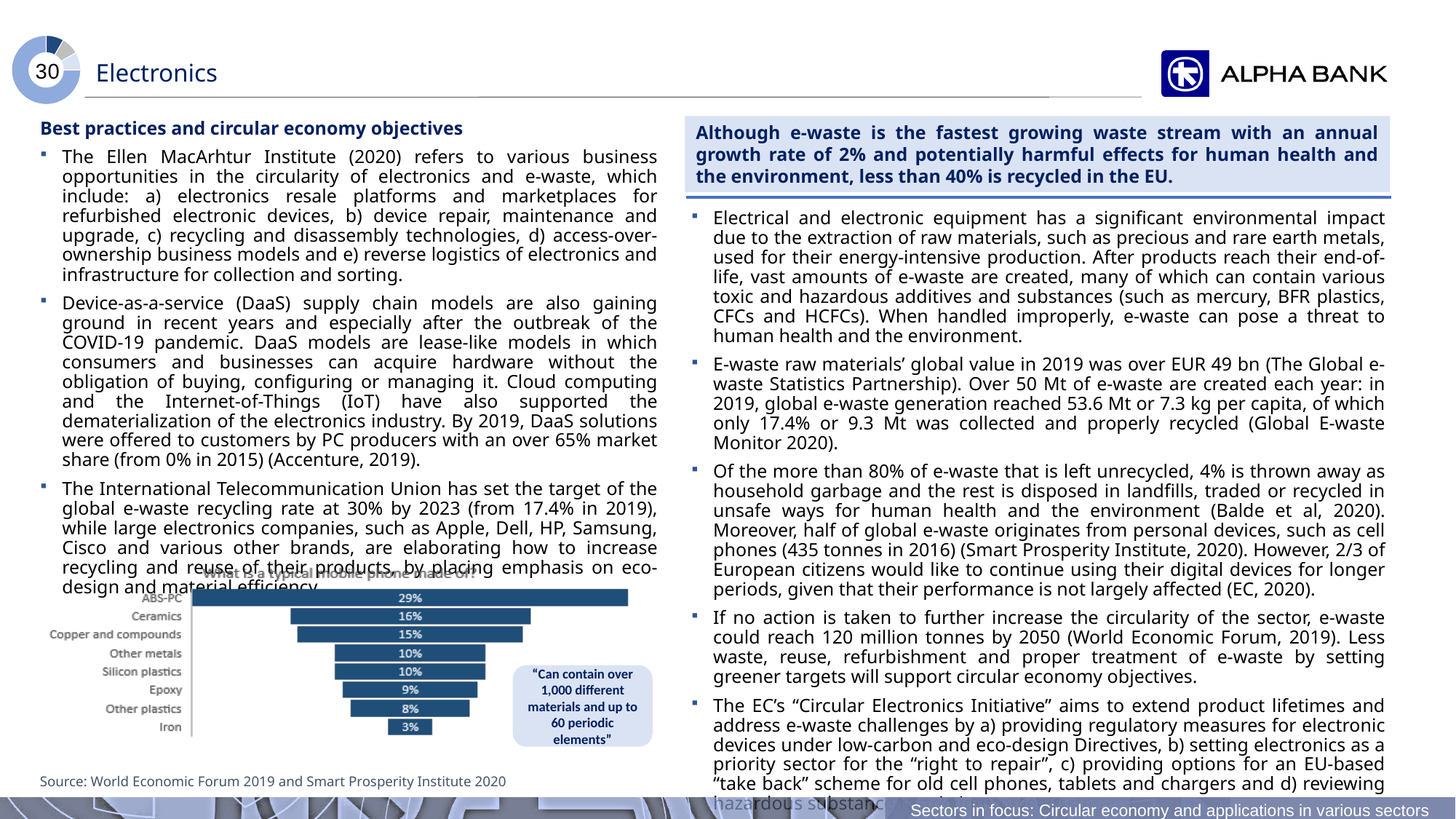
Which is larger, the value for Ceramics or the value for Copper and compounds? Ceramics What type of chart is used to show the composition of a typical mobile phone? Bar chart What is the difference between the values for Epoxy and Other plastics? 1% What percentage of a typical mobile phone is ABS-PC according to the chart? 29% What is the difference between the values for ABS-PC and Ceramics? 13% Which material has the highest share in the chart? ABS-PC What percentage does the chart show for Copper and compounds? 15% What is the value shown for Iron in the chart? 3% Which two materials in the chart share the same value of 10%? Other metals and Silicon plastics How many material categories are shown in the chart? 8 What is the value shown for Ceramics in the chart? 16% Which material has the lowest share in the chart? Iron